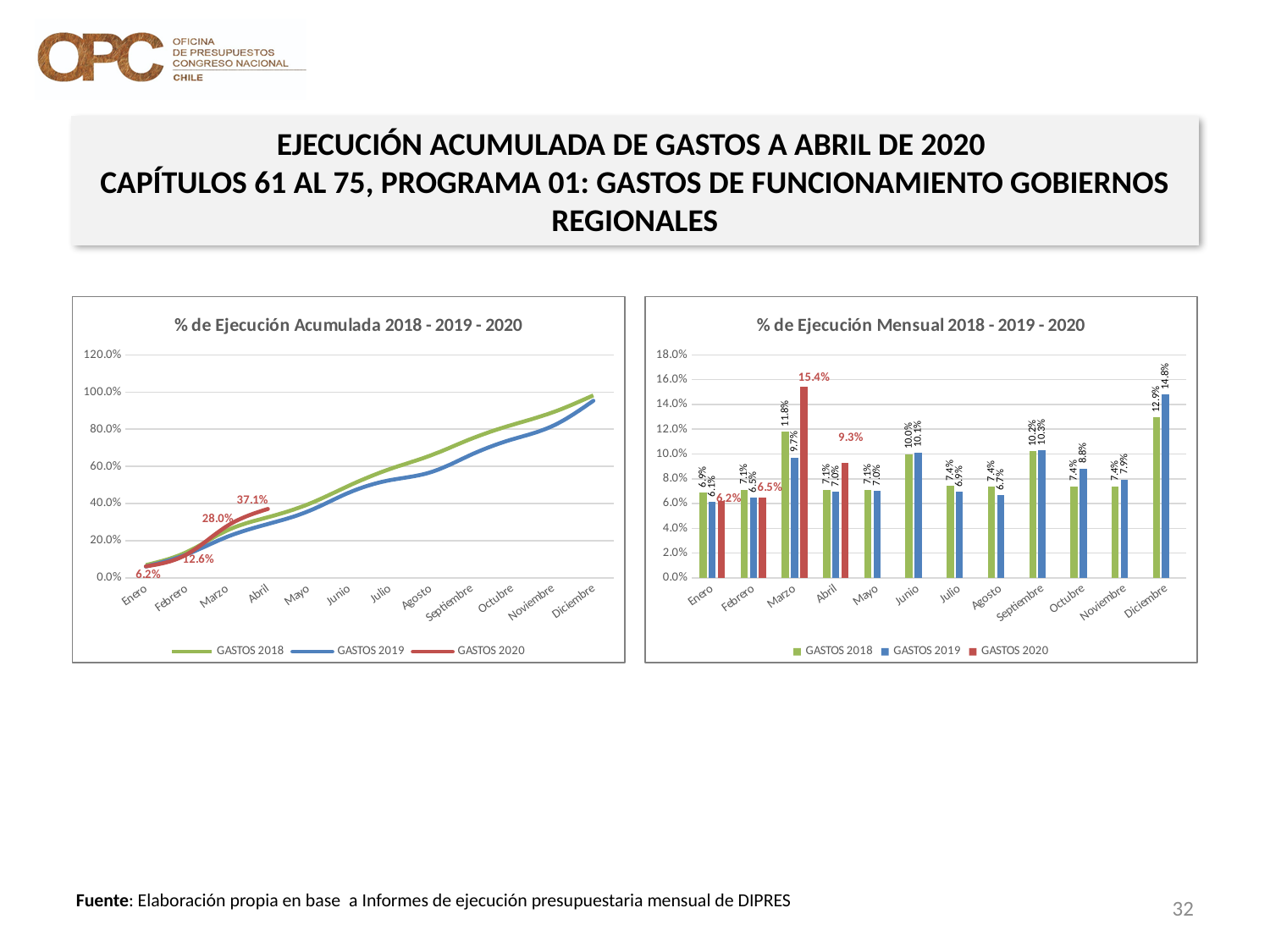
In the chart titled "% de Ejecución Mensual 2018 - 2019 - 2020", what is the value for GASTOS 2019 in Diciembre? 14.8% In the chart titled "% de Ejecución Mensual 2018 - 2019 - 2020", what is the value for GASTOS 2020 in Marzo? 15.4% In the chart titled "% de Ejecución Mensual 2018 - 2019 - 2020", how many months are shown on the x axis? 12 In the chart titled "% de Ejecución Acumulada 2018 - 2019 - 2020", how many series does the legend list? 3 In the chart titled "% de Ejecución Acumulada 2018 - 2019 - 2020", do the GASTOS 2018 values rise or fall from Enero to Diciembre? Rise In the chart titled "% de Ejecución Acumulada 2018 - 2019 - 2020", is the GASTOS 2019 value in Diciembre greater or less than 80.0%? greater In the chart titled "% de Ejecución Acumulada 2018 - 2019 - 2020", what kind of chart is shown? Line chart In the chart titled "% de Ejecución Mensual 2018 - 2019 - 2020", which month has the highest GASTOS 2018 value? Diciembre In the chart titled "% de Ejecución Acumulada 2018 - 2019 - 2020", what is the value for GASTOS 2020 in Marzo? 28.0% In the chart titled "% de Ejecución Mensual 2018 - 2019 - 2020", which is larger in Abril: GASTOS 2018 or GASTOS 2020? GASTOS 2020 In the chart titled "% de Ejecución Acumulada 2018 - 2019 - 2020", what is the value for GASTOS 2020 in Abril? 37.1% In the chart titled "% de Ejecución Mensual 2018 - 2019 - 2020", what is the difference between GASTOS 2020 and GASTOS 2019 in Marzo? 5.7%